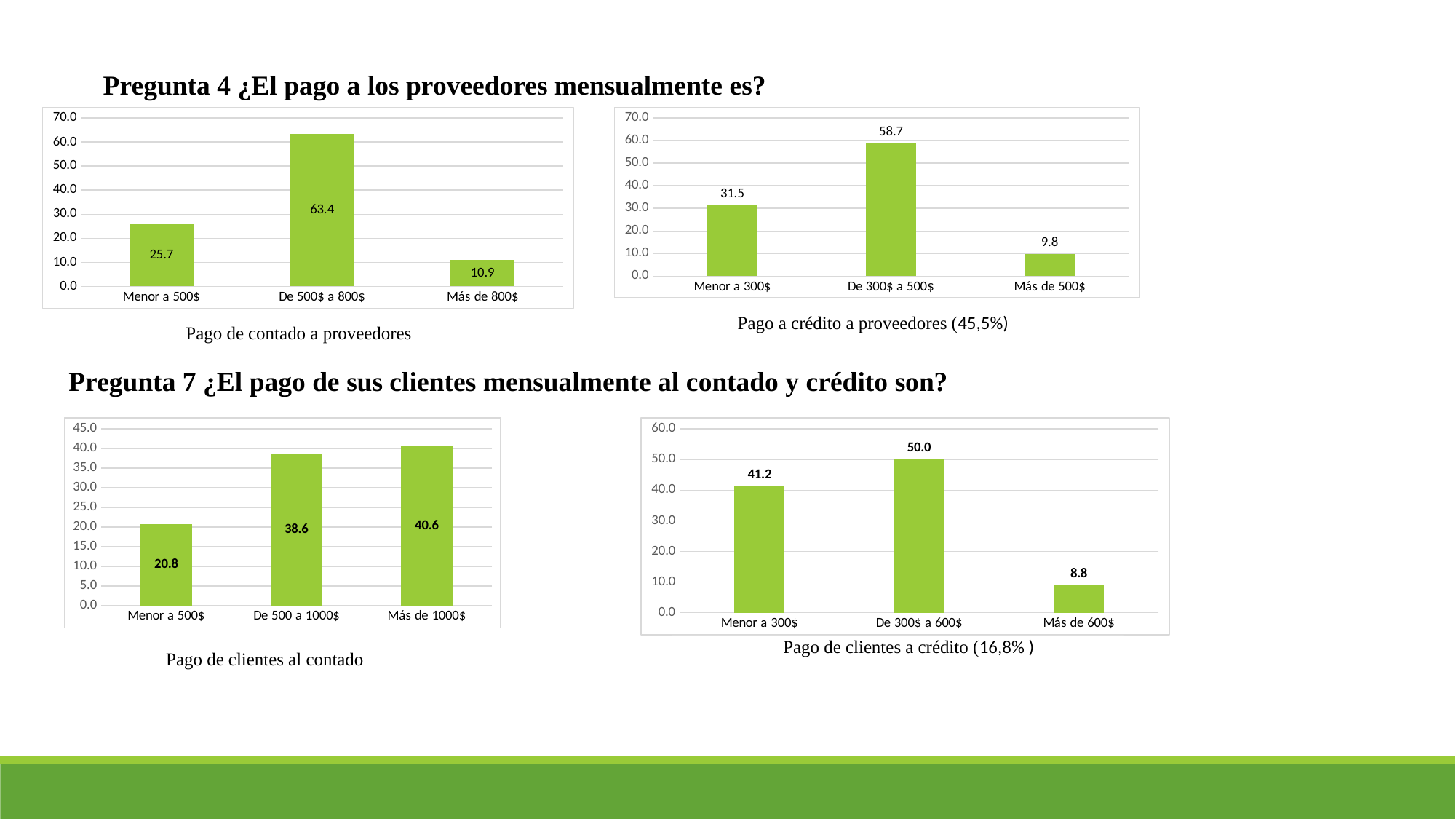
How many categories are shown in the 'Pago de clientes al contado' chart? 3 In the 'Pago de clientes a crédito (16,8%)' chart, is the value for 'Menor a 300$' greater or less than 30.0? greater In the 'Pago a crédito a proveedores (45,5%)' chart, which is larger: 'Menor a 300$' or 'Más de 500$'? Menor a 300$ In the 'Pago a crédito a proveedores (45,5%)' chart, what is the value for 'Más de 500$'? 9.8 In the 'Pago de contado a proveedores' chart, what is the value for 'De 500$ a 800$'? 63.4 In the 'Pago de clientes al contado' chart, what is the value for 'Menor a 500$'? 20.8 In the 'Pago de clientes a crédito (16,8%)' chart, which category has the lowest value? Más de 600$ What kind of chart is the 'Pago a crédito a proveedores (45,5%)' chart? bar chart In the 'Pago de clientes al contado' chart, which category has the highest value? Más de 1000$ In the 'Pago de contado a proveedores' chart, what is the difference between the values for 'De 500$ a 800$' and 'Menor a 500$'? 37.7 How many charts are shown on the slide? 4 In the 'Pago de clientes a crédito (16,8%)' chart, what is the difference between the values for 'De 300$ a 600$' and 'Más de 600$'? 41.2